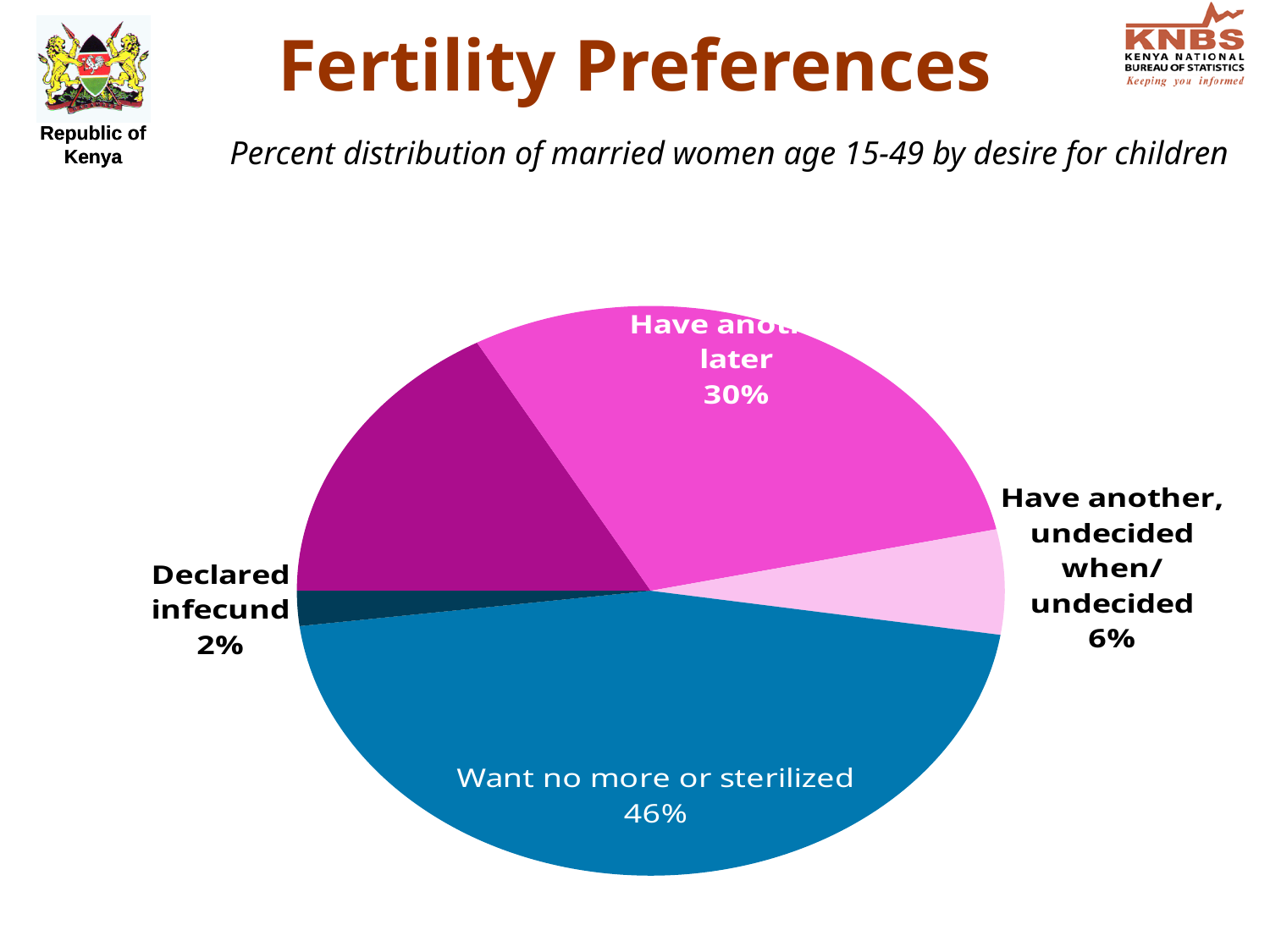
What is the title of the slide containing the chart? Fertility Preferences Which labelled category has the smallest share of the pie? Declared infecund What percentage of married women want to have another child later? 30% Which is larger: the share for 'Have another later' or the share for 'Have another, undecided when/undecided'? Have another later What percentage of married women want to have another child but are undecided when or undecided? 6% What kind of chart is shown on the slide? Pie chart What percentage of married women want no more children or are sterilized? 46% What percentage of married women are declared infecund? 2% How many percentage points larger is 'Want no more or sterilized' than 'Have another later'? 16 percentage points How many slices does the pie chart have? 5 Which category has the largest share of the pie? Want no more or sterilized What is the difference in percentage points between 'Have another, undecided when/undecided' and 'Declared infecund'? 4 percentage points